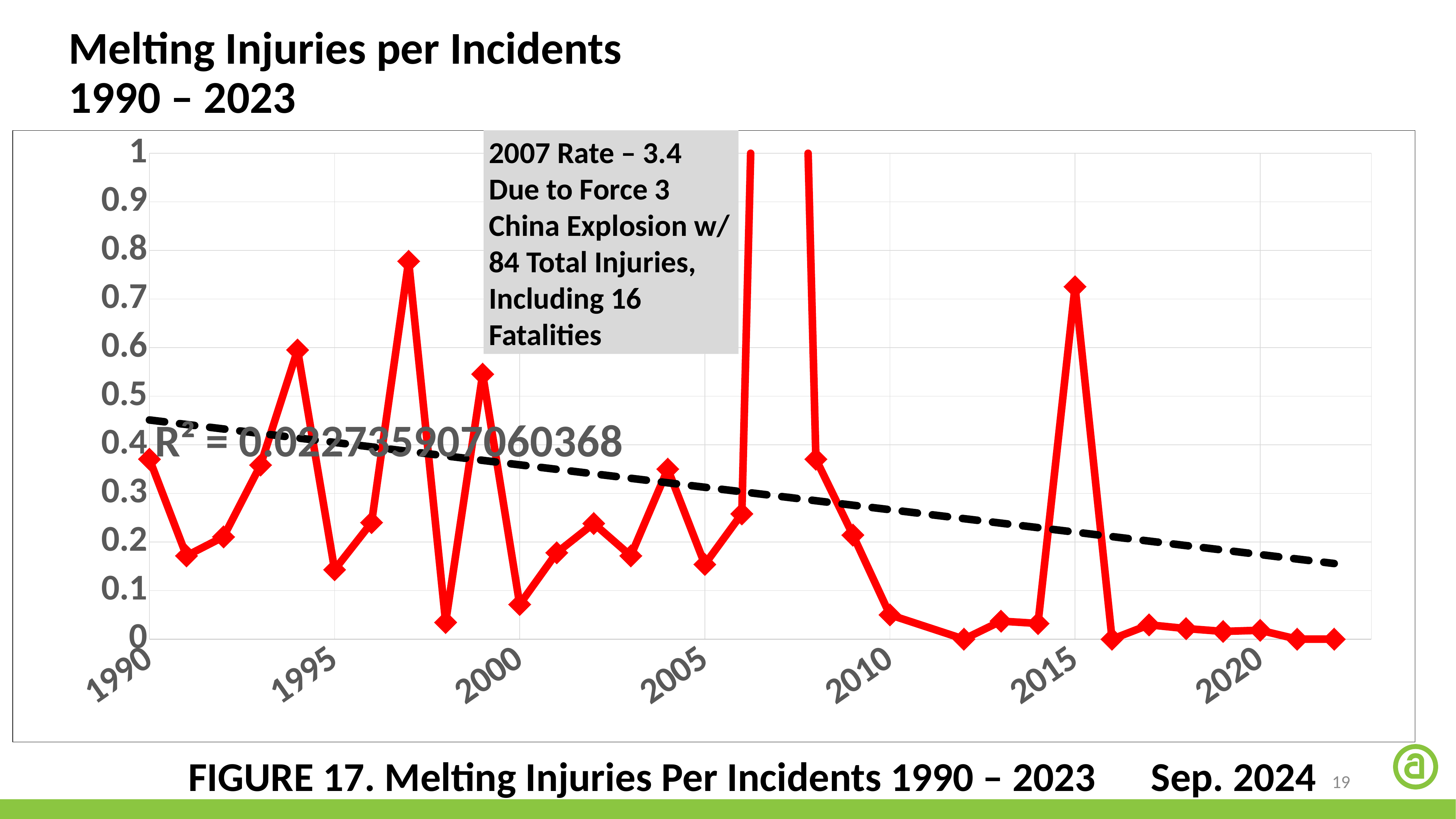
Does the dashed trend line rise or fall from 1990 to 2023? fall Which year has the larger value, 1997 or 1994? 1997 What kind of chart is shown on the slide? line chart What is the title of the chart on the slide? Melting Injuries per Incidents 1990 – 2023 Which year has the larger value, 2015 or 2005? 2015 Is the value for 1990 greater or less than 0.3? greater Is the value for 1994 greater or less than 0.5? greater Is the value for 2000 greater or less than 0.1? less Which year has the highest melting injuries per incident rate? 2007 According to the annotation, how many fatalities were included in the 2007 China explosion? 16 According to the annotation on the chart, what was the rate in 2007? 3.4